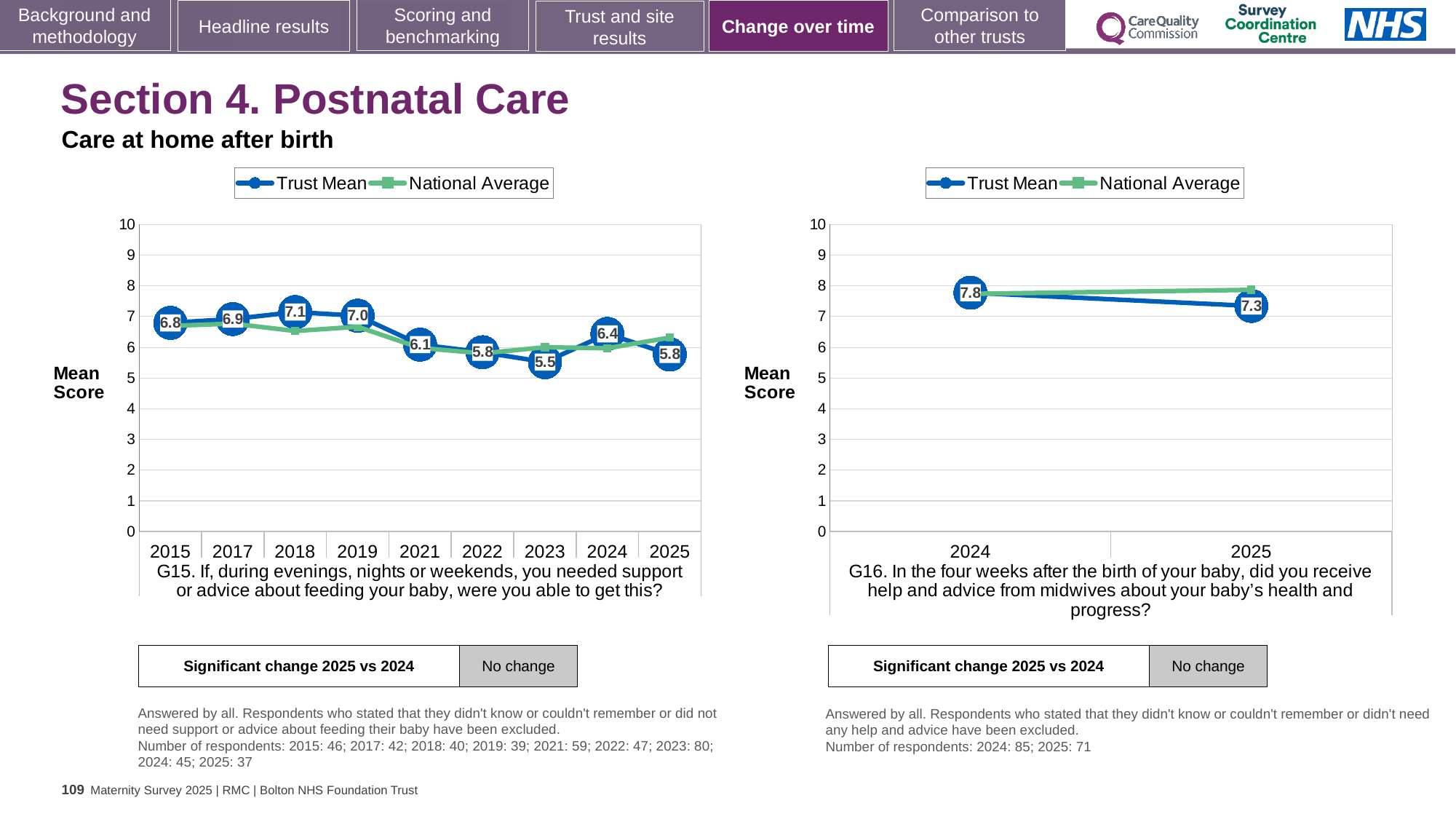
In the G16 chart on the right, what is the Trust Mean score for 2025? 7.3 In the G15 chart on the left, which year has the lowest Trust Mean score? 2023 In the G15 chart on the left, is the Trust Mean score higher in 2019 or in 2021? 2019 In the G15 chart on the left, what is the difference between the Trust Mean scores for 2024 and 2025? 0.6 In the G15 chart on the left, what is the Trust Mean score for 2018? 7.1 In the G16 chart on the right, what is the difference between the Trust Mean scores for 2024 and 2025? 0.5 How many years are shown on the x axis of the G15 chart on the left? 9 What type of chart is the G16 chart on the right? Line chart In the G15 chart on the left, is the National Average value for 2018 greater or less than 7? less In the G15 chart on the left, which year has the highest Trust Mean score? 2018 How many series does the legend of the G16 chart on the right list? 2 In the G15 chart on the left, what is the Trust Mean score for 2023? 5.5